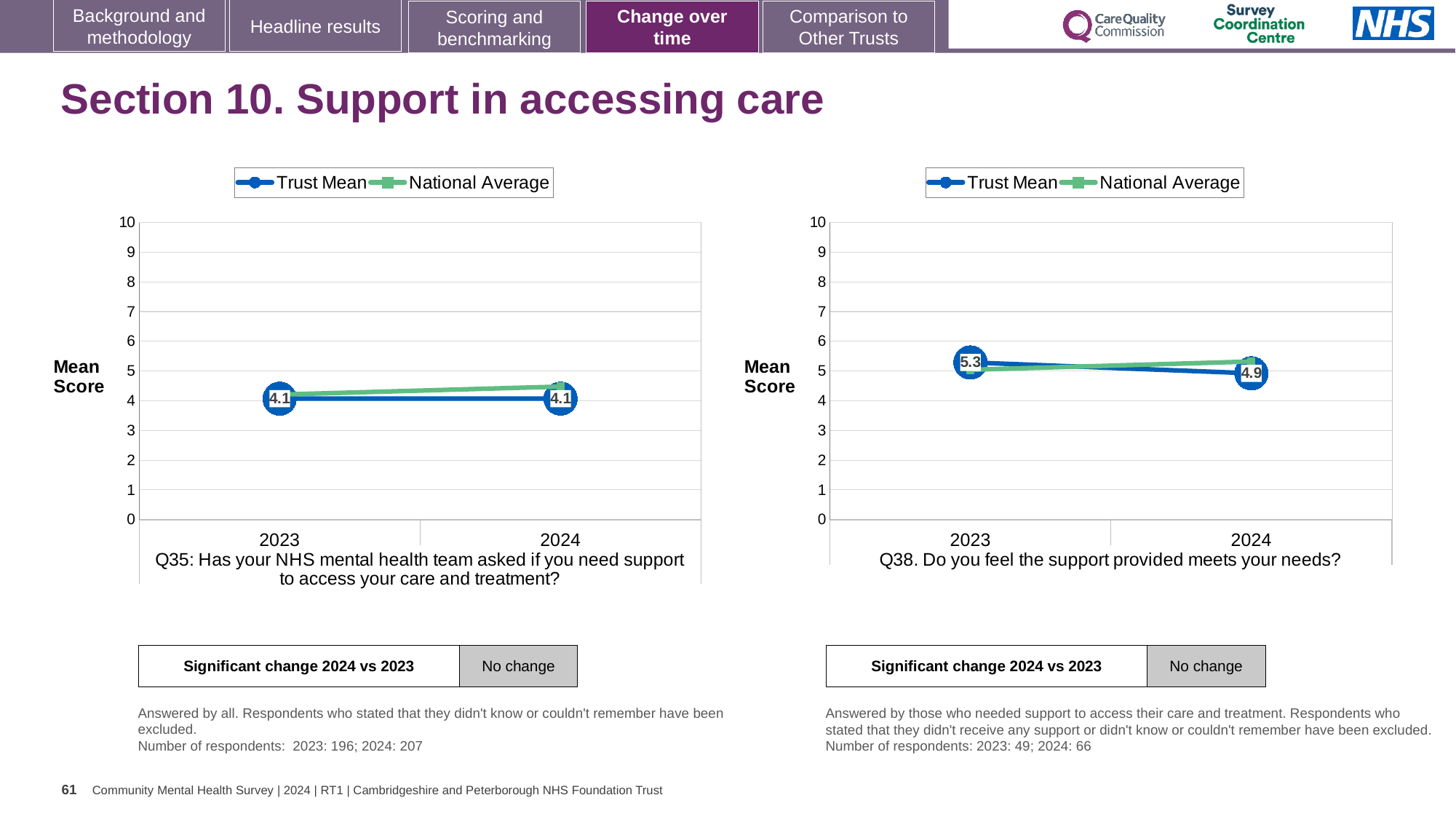
In the Q38 chart on the right, which year has the higher Trust Mean, 2023 or 2024? 2023 In the Q38 chart on the right, what is the Trust Mean for 2023? 5.3 In the Q35 chart on the left, what is the Trust Mean for 2024? 4.1 What kind of chart is the Q35 chart on the left? line chart In the Q35 chart on the left, what is the Trust Mean for 2023? 4.1 In the Q38 chart on the right, does the Trust Mean rise or fall from 2023 to 2024? fall How many series does the legend of the Q35 chart on the left list? 2 In the Q38 chart on the right, is the National Average for 2023 greater or less than 6? less In the Q35 chart on the left, is the National Average for 2024 greater or less than 5? less How many years are plotted on the x axis of the Q38 chart on the right? 2 In the Q38 chart on the right, by how much did the Trust Mean change from 2023 to 2024? 0.4 In the Q38 chart on the right, what is the Trust Mean for 2024? 4.9